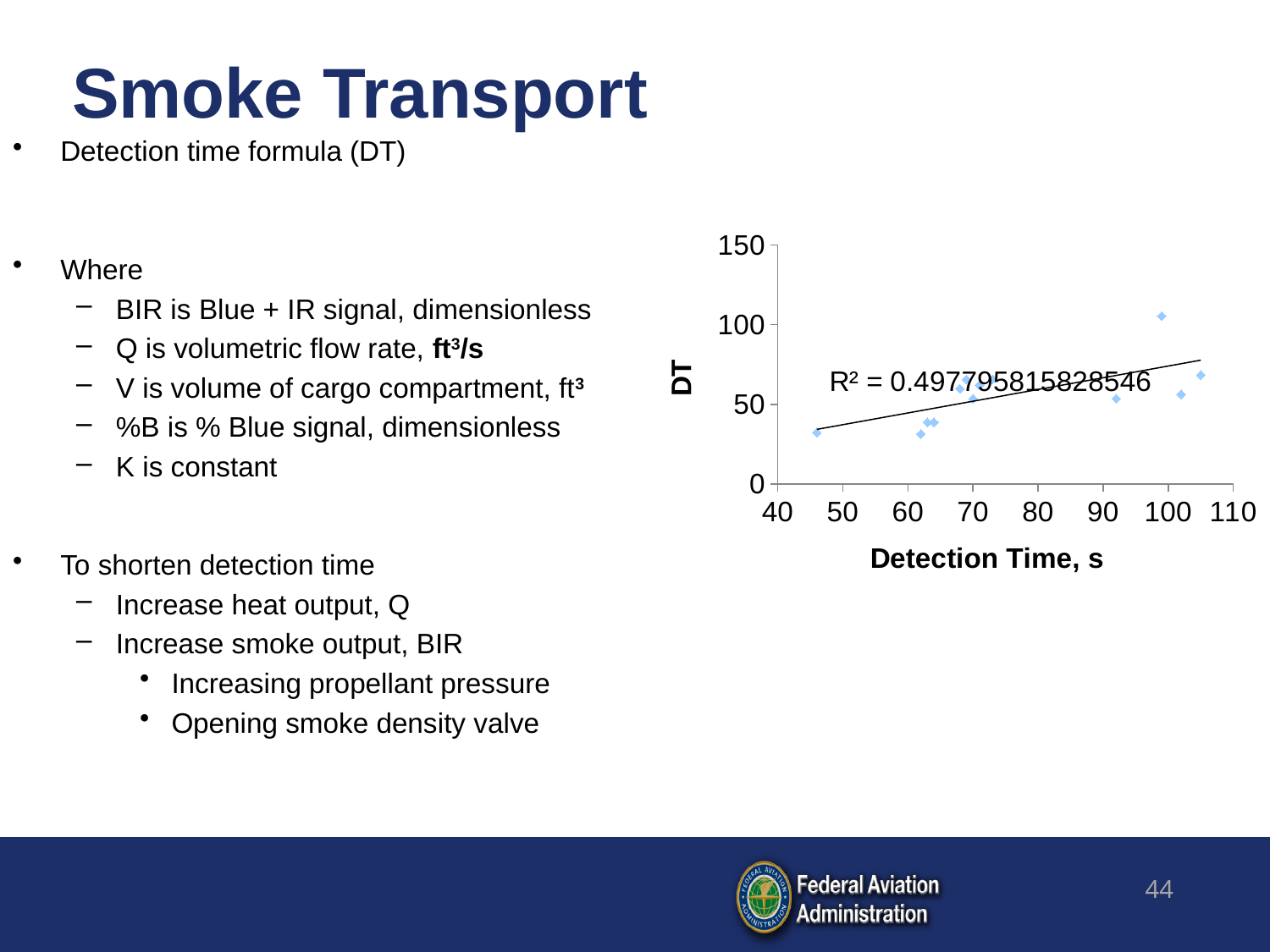
According to the trendline, does DT rise or fall as detection time increases? rise Is the detection time of the point with the highest DT greater or less than 90 s? greater Is the detection time of the rightmost point greater or less than 100 s? greater Is the highest DT value plotted greater or less than 150? less What is the R² value printed on the chart? R² = 0.497795815828546 What kind of chart is shown on the slide? scatter chart What is the title of the x axis of the chart? Detection Time, s Does the fitted trendline slope upward or downward from left to right? upward